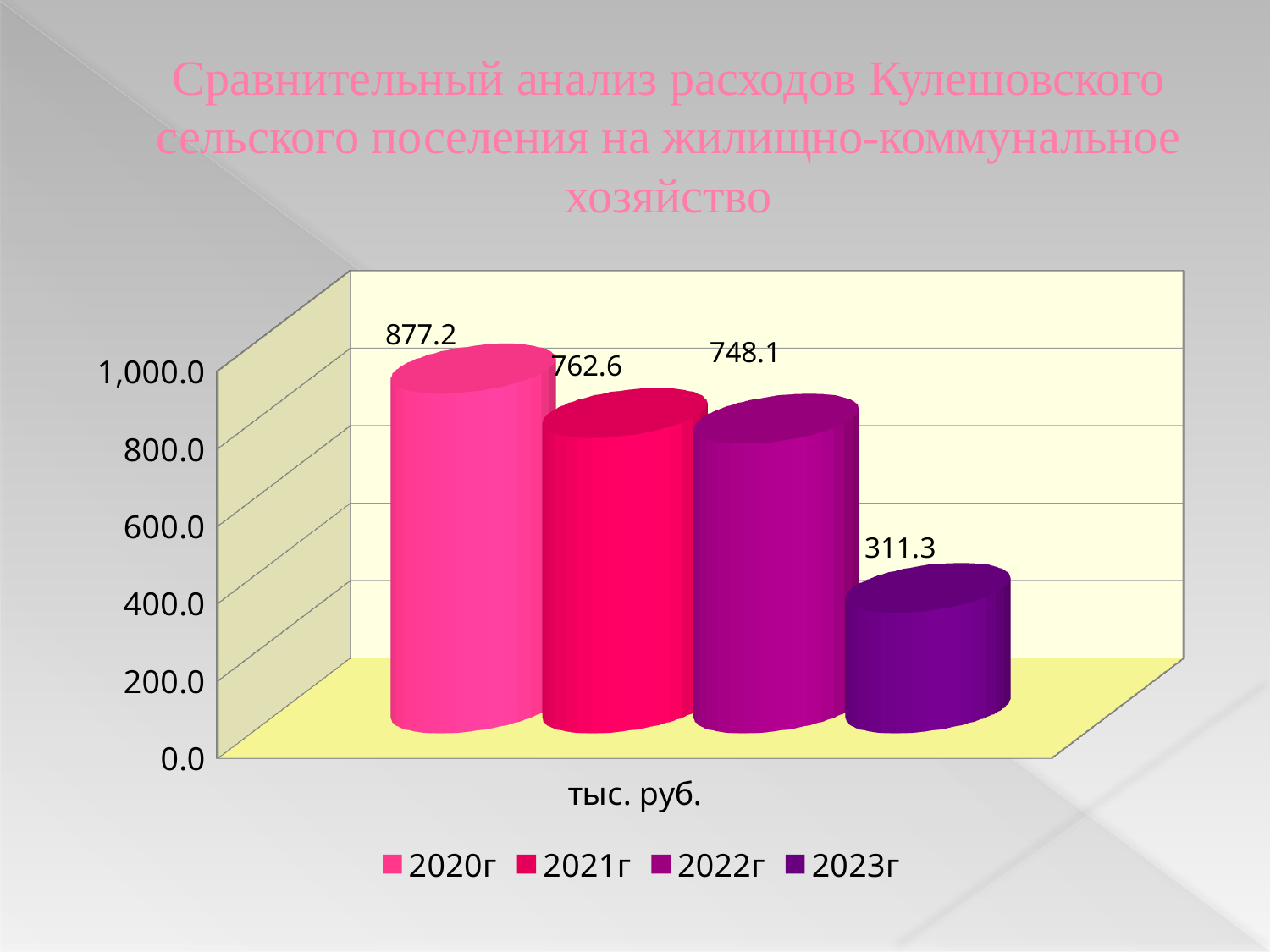
What is the category axis label shown below the bars? тыс. руб. What is the value for 2020г? 877.2 Which year has the highest value? 2020г Which is larger, the value for 2020г or the value for 2021г? 2020г What is the difference between the values for 2020г and 2023г? 565.9 Which year has the lowest value? 2023г What is the value for 2023г? 311.3 What is the value for 2021г? 762.6 What is the value for 2022г? 748.1 What kind of chart is shown on the slide? bar chart What is the difference between the values for 2021г and 2022г? 14.5 How many series does the legend list? 4